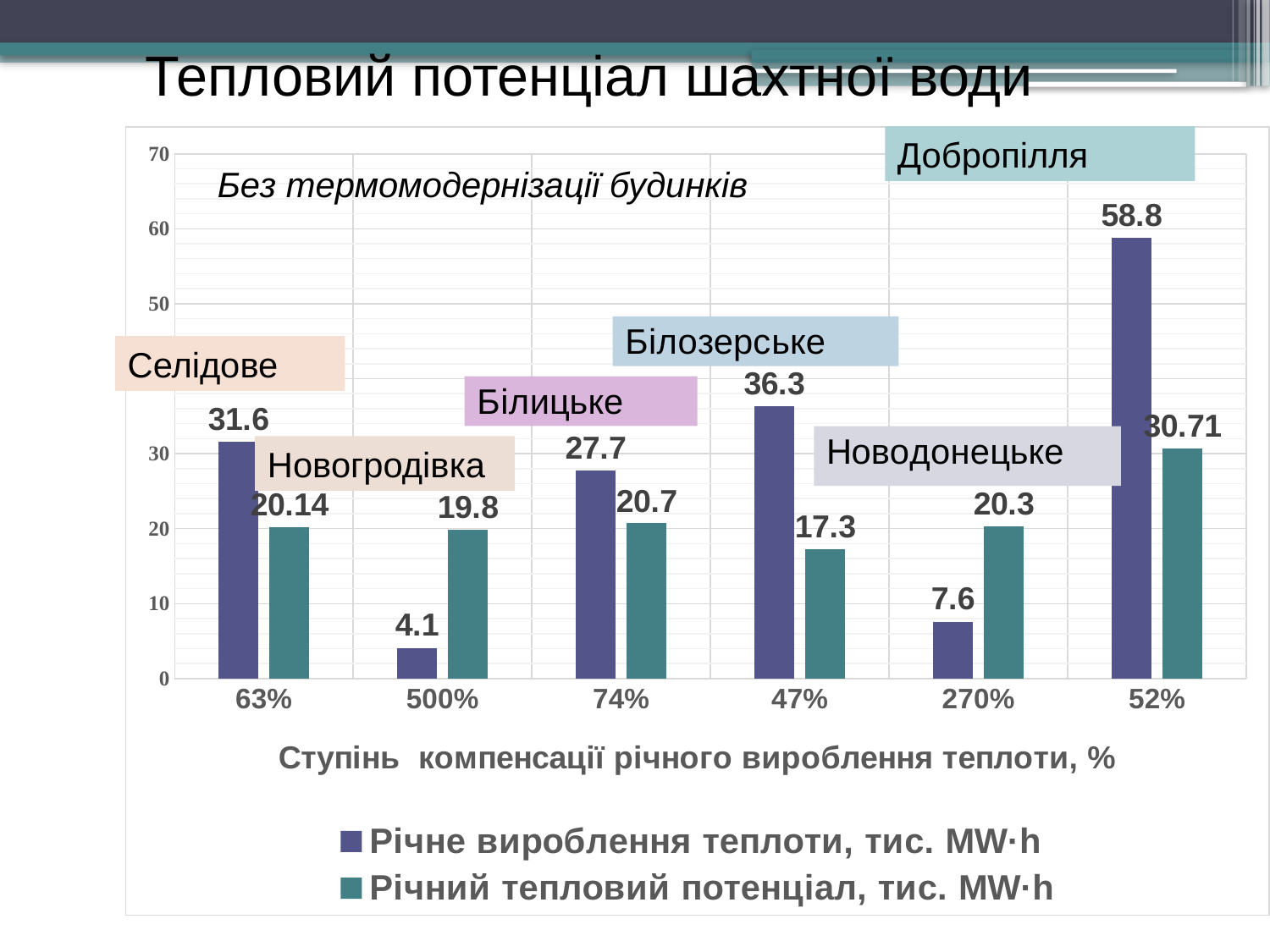
What is the x-axis title of the chart? Ступінь компенсації річного вироблення теплоти, % How many series does the legend list? 2 What is the value of 'Річне вироблення теплоти, тис. MW·h' for the 63% category? 31.6 How many categories are shown on the x axis? 6 Which category has the lowest value of 'Річне вироблення теплоти, тис. MW·h'? 500% Which category has the lowest value of 'Річний тепловий потенціал, тис. MW·h'? 47% What type of chart is shown on the slide? bar chart For the 270% category, which is larger: 'Річне вироблення теплоти' or 'Річний тепловий потенціал'? Річний тепловий потенціал What is the difference between 'Річне вироблення теплоти' and 'Річний тепловий потенціал' for the 47% category? 19 What is the value of 'Річний тепловий потенціал, тис. MW·h' for the 52% category? 30.71 Which category has the highest value of 'Річне вироблення теплоти, тис. MW·h'? 52% What is the value of 'Річний тепловий потенціал, тис. MW·h' for the 500% category? 19.8